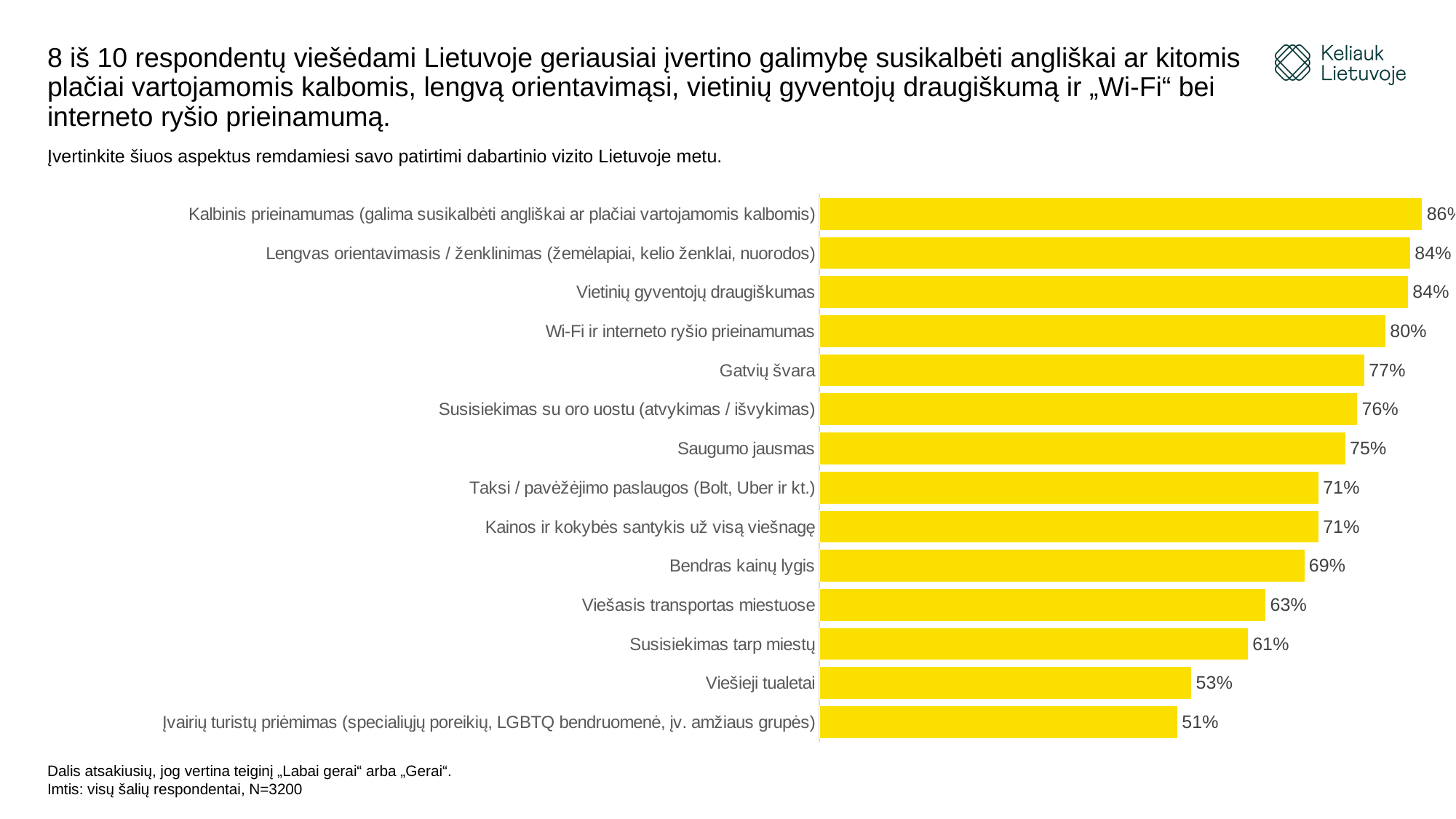
What is the difference between the values for Saugumo jausmas and Susisiekimas tarp miestų? 14% What is the value for Wi-Fi ir interneto ryšio prieinamumas? 80% What colour are the bars in the chart? Yellow Which category has the highest value? Kalbinis prieinamumas (galima susikalbėti angliškai ar plačiai vartojamomis kalbomis) What kind of chart is shown on the slide? Bar chart What is the value for Gatvių švara? 77% How many categories are shown in the chart? 14 What is the value for Taksi / pavėžėjimo paslaugos (Bolt, Uber ir kt.)? 71% Which category has the lowest value? Įvairių turistų priėmimas (specialiųjų poreikių, LGBTQ bendruomenė, įv. amžiaus grupės) What is the value for Viešieji tualetai? 53% Which is larger: the value for Bendras kainų lygis or the value for Viešasis transportas miestuose? Bendras kainų lygis What is the difference between the highest and lowest values in the chart? 35%